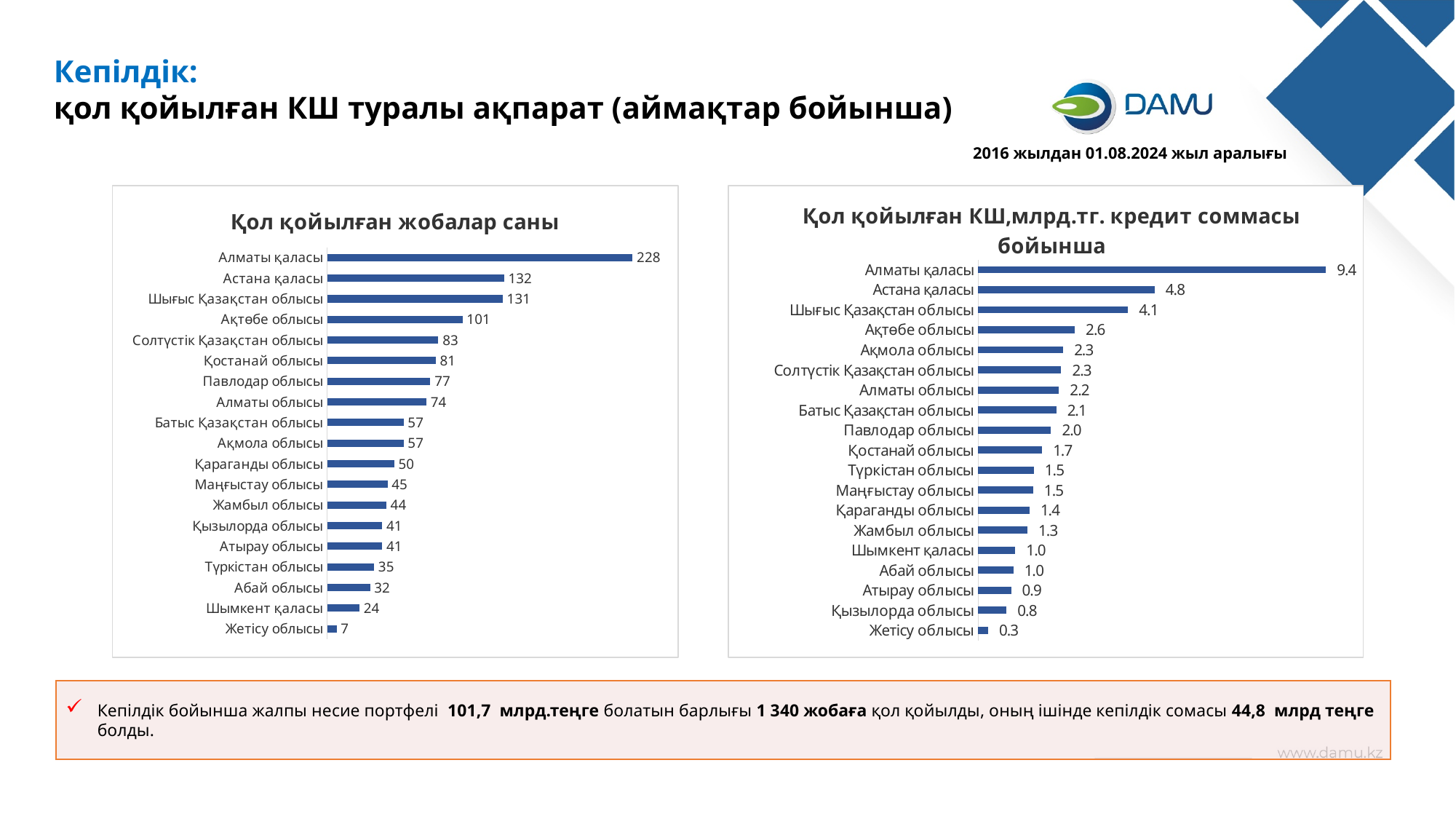
In the right chart 'Қол қойылған КШ,млрд.тг. кредит соммасы бойынша', what is the value for Жетісу облысы? 0.3 In the right chart 'Қол қойылған КШ,млрд.тг. кредит соммасы бойынша', what is the value for Павлодар облысы? 2.0 In the right chart 'Қол қойылған КШ,млрд.тг. кредит соммасы бойынша', what is the difference between Алматы қаласы and Астана қаласы? 4.6 What is the title of the left chart? Қол қойылған жобалар саны In the right chart 'Қол қойылған КШ,млрд.тг. кредит соммасы бойынша', which is larger: Ақтөбе облысы or Қостанай облысы? Ақтөбе облысы In the left chart 'Қол қойылған жобалар саны', which category has the lowest value? Жетісу облысы In the left chart 'Қол қойылған жобалар саны', what is the difference between Астана қаласы and Шымкент қаласы? 108 In the left chart 'Қол қойылған жобалар саны', what is the value for Ақтөбе облысы? 101 What type of chart is the left chart 'Қол қойылған жобалар саны'? Bar chart In the left chart 'Қол қойылған жобалар саны', which category has the highest value? Алматы қаласы In the right chart 'Қол қойылған КШ,млрд.тг. кредит соммасы бойынша', which category has the highest value? Алматы қаласы In the left chart 'Қол қойылған жобалар саны', how many categories are shown? 19